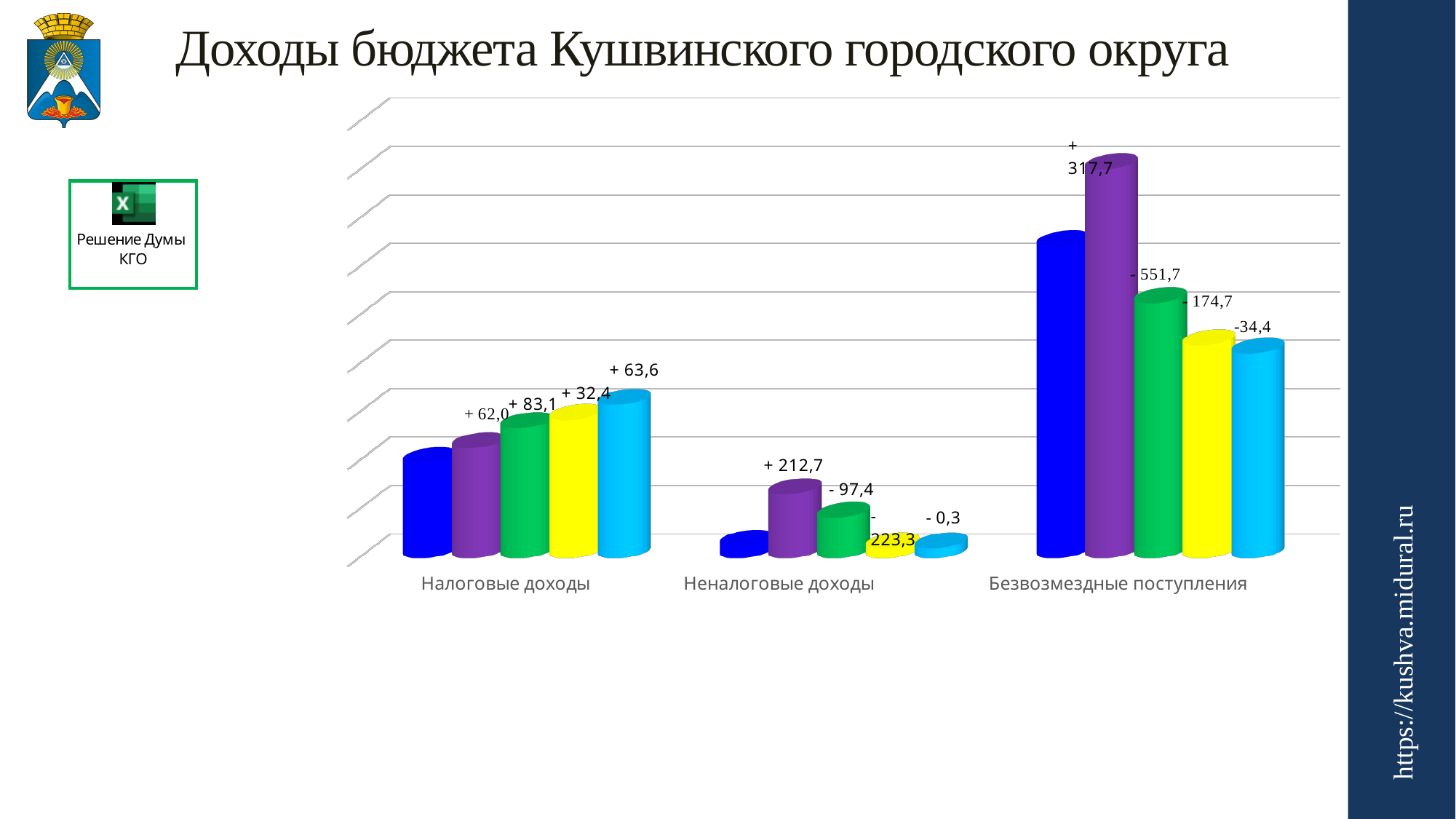
Which category has the shortest bars in the chart? Неналоговые доходы What label is printed above the yellow bar for Безвозмездные поступления? - 174,7 What kind of chart is shown on the slide? bar chart What label is printed above the green bar for Безвозмездные поступления? - 551,7 What label is printed above the purple bar for Неналоговые доходы? + 212,7 What is the title of the slide with the chart? Доходы бюджета Кушвинского городского округа How many categories are shown on the x axis of the chart? 3 Which category has the tallest bars in the chart? Безвозмездные поступления What label is printed above the purple bar for Безвозмездные поступления? + 317,7 How many bars are plotted for each category in the chart? 5 What label is printed above the green bar for Налоговые доходы? + 83,1 What label is printed above the light blue bar for Неналоговые доходы? - 0,3